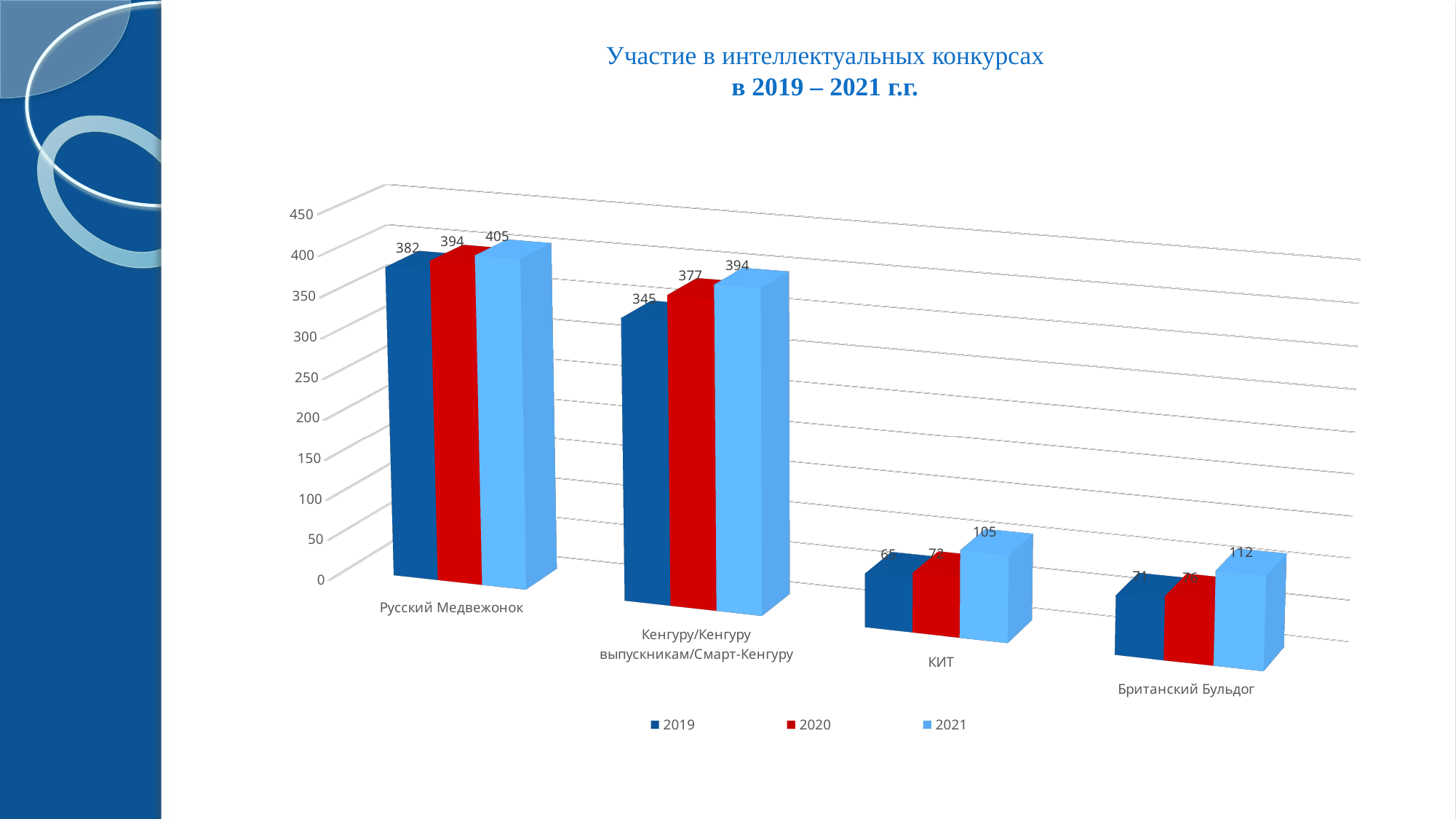
What is the value for КИТ in 2021? 105 How many series does the legend list? 3 Is the value for Британский Бульдог in 2019 greater or less than 100? less Which category has the highest value in 2021? Русский Медвежонок By how much did the value for Русский Медвежонок increase from 2019 to 2021? 23 What is the value for Кенгуру/Кенгуру выпускникам/Смарт-Кенгуру in 2019? 345 What is the value for Британский Бульдог in 2021? 112 Which is larger in 2020: Русский Медвежонок or Кенгуру/Кенгуру выпускникам/Смарт-Кенгуру? Русский Медвежонок How many categories (competitions) are shown on the chart? 4 Do the values for Кенгуру/Кенгуру выпускникам/Смарт-Кенгуру rise or fall from 2019 to 2021? rise Which category has the lowest value in 2021? КИТ What is the value for Русский Медвежонок in 2021? 405